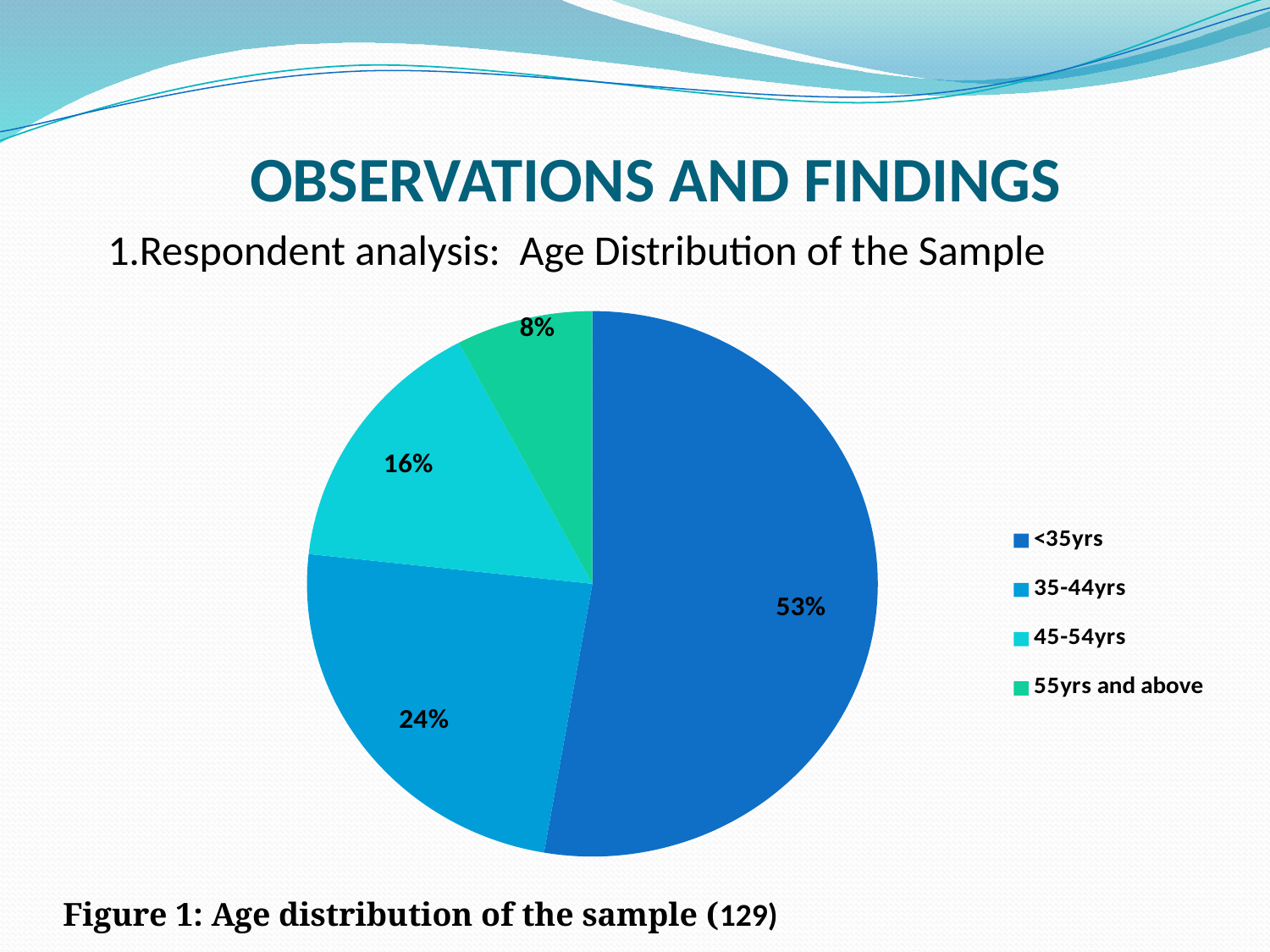
Which age group has the largest share of the sample? <35yrs What kind of chart is shown on the slide? pie chart How many age groups are shown in the pie chart? 4 What is the combined share of the 45-54yrs and 55yrs and above groups? 24% What is the difference in percentage points between the <35yrs and 35-44yrs groups? 29 What is the caption given for the chart below it? Figure 1: Age distribution of the sample (129) What share of the sample is in the <35yrs age group? 53% What share of the sample is in the 45-54yrs age group? 16% What share of the sample is in the 35-44yrs age group? 24% What share of the sample is in the 55yrs and above age group? 8% Which group has a larger share: 45-54yrs or 55yrs and above? 45-54yrs Which age group has the smallest share of the sample? 55yrs and above